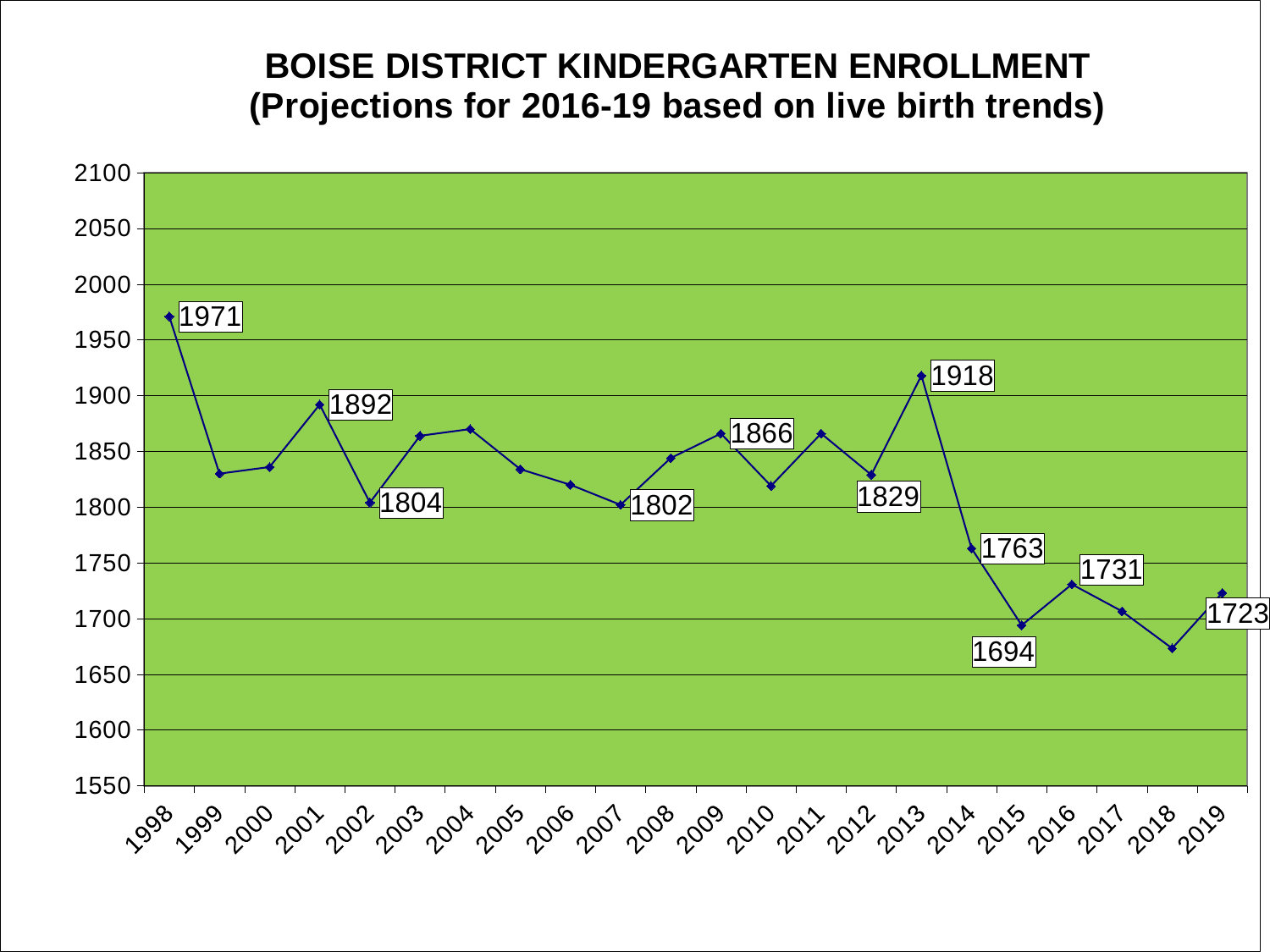
Which year had higher enrollment, 2001 or 2013? 2013 What kind of chart is shown on the slide? Line chart What is the projected enrollment for 2019? 1723 What is the difference between the enrollment in 1998 and the enrollment in 2015? 277 How many years are plotted on the x axis? 22 Is the enrollment value for 2004 greater or less than 1850? greater Which year has the lowest kindergarten enrollment on the chart? 2018 By how much did enrollment drop from 2013 to 2014? 155 What was the Boise District kindergarten enrollment in 1998? 1971 Is the enrollment value for 2018 greater or less than 1700? less Which year has the highest kindergarten enrollment on the chart? 1998 What is the enrollment value shown for 2013? 1918